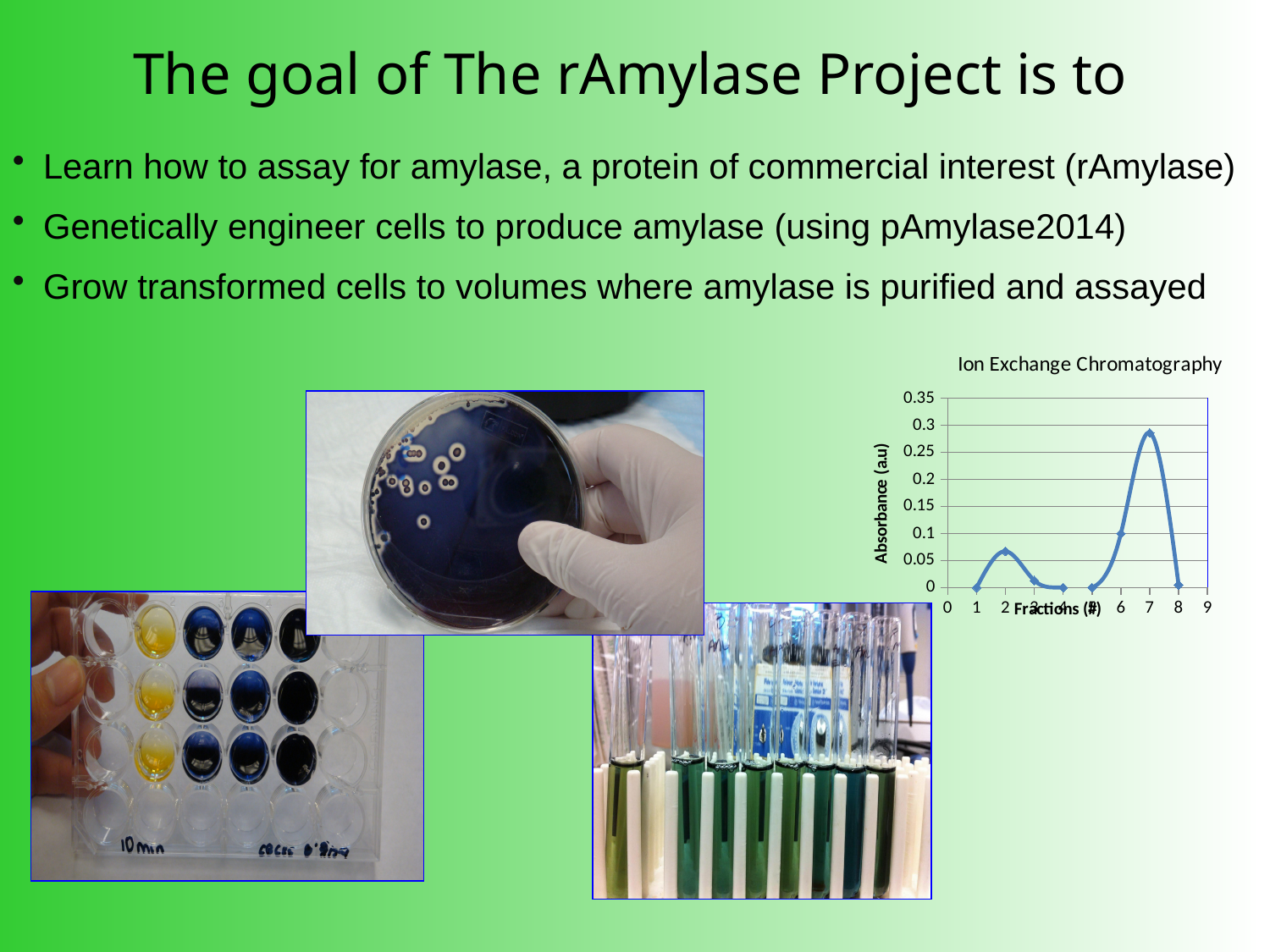
In the Ion Exchange Chromatography chart, which has the higher absorbance, fraction 2 or fraction 4? fraction 2 What is the title of the chart on the slide? Ion Exchange Chromatography In the Ion Exchange Chromatography chart, at which fraction number is the absorbance highest? 7 In the Ion Exchange Chromatography chart, is the absorbance at fraction 7 greater or less than 0.25? greater In the Ion Exchange Chromatography chart, does the absorbance rise or fall from fraction 7 to fraction 8? fall In the Ion Exchange Chromatography chart, does the absorbance rise or fall from fraction 5 to fraction 7? rise In the Ion Exchange Chromatography chart, how many data points are plotted on the line? 8 In the Ion Exchange Chromatography chart, is the absorbance at fraction 3 greater or less than 0.05? less In the Ion Exchange Chromatography chart, is the absorbance at fraction 2 greater or less than 0.1? less In the Ion Exchange Chromatography chart, what is the label of the y axis? Absorbance (a.u) What kind of chart is the Ion Exchange Chromatography chart? line chart In the Ion Exchange Chromatography chart, which has the higher absorbance, fraction 2 or fraction 7? fraction 7